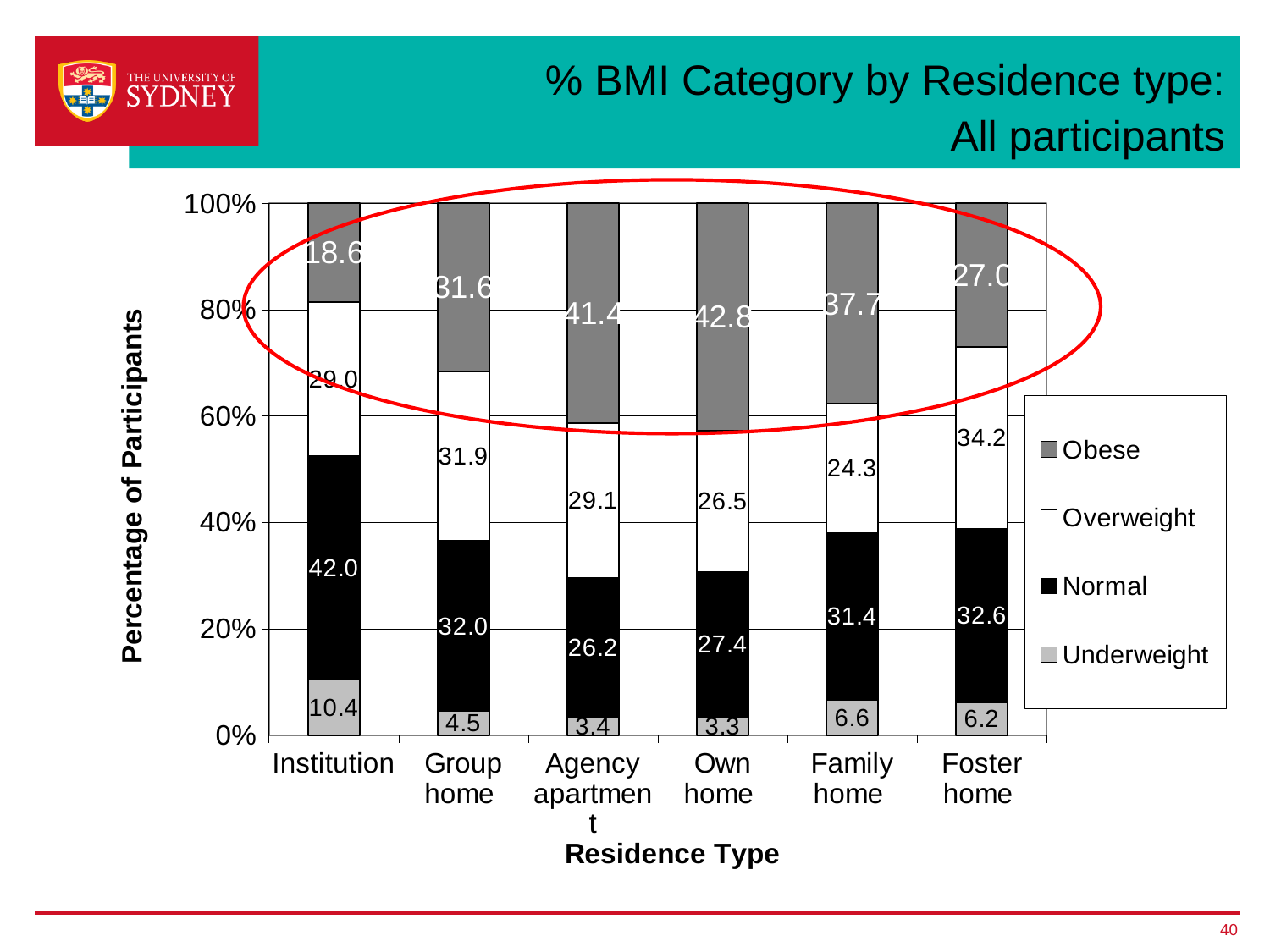
What is the Obese percentage for Own home? 42.8 How many series does the legend list? 4 How many residence types are shown on the x axis? 6 What kind of chart is shown on the slide? Stacked bar chart Which residence type has the lowest Underweight percentage? Own home What is the Overweight percentage for Group home? 31.9 What is the difference between the Obese percentages for Agency apartment and Institution? 22.8 Which residence type has the highest Obese percentage? Own home Which is larger, the Overweight percentage for Foster home or for Family home? Foster home What is the Underweight percentage for Institution? 10.4 What is the Normal percentage for Foster home? 32.6 Which residence type has the highest Normal percentage? Institution